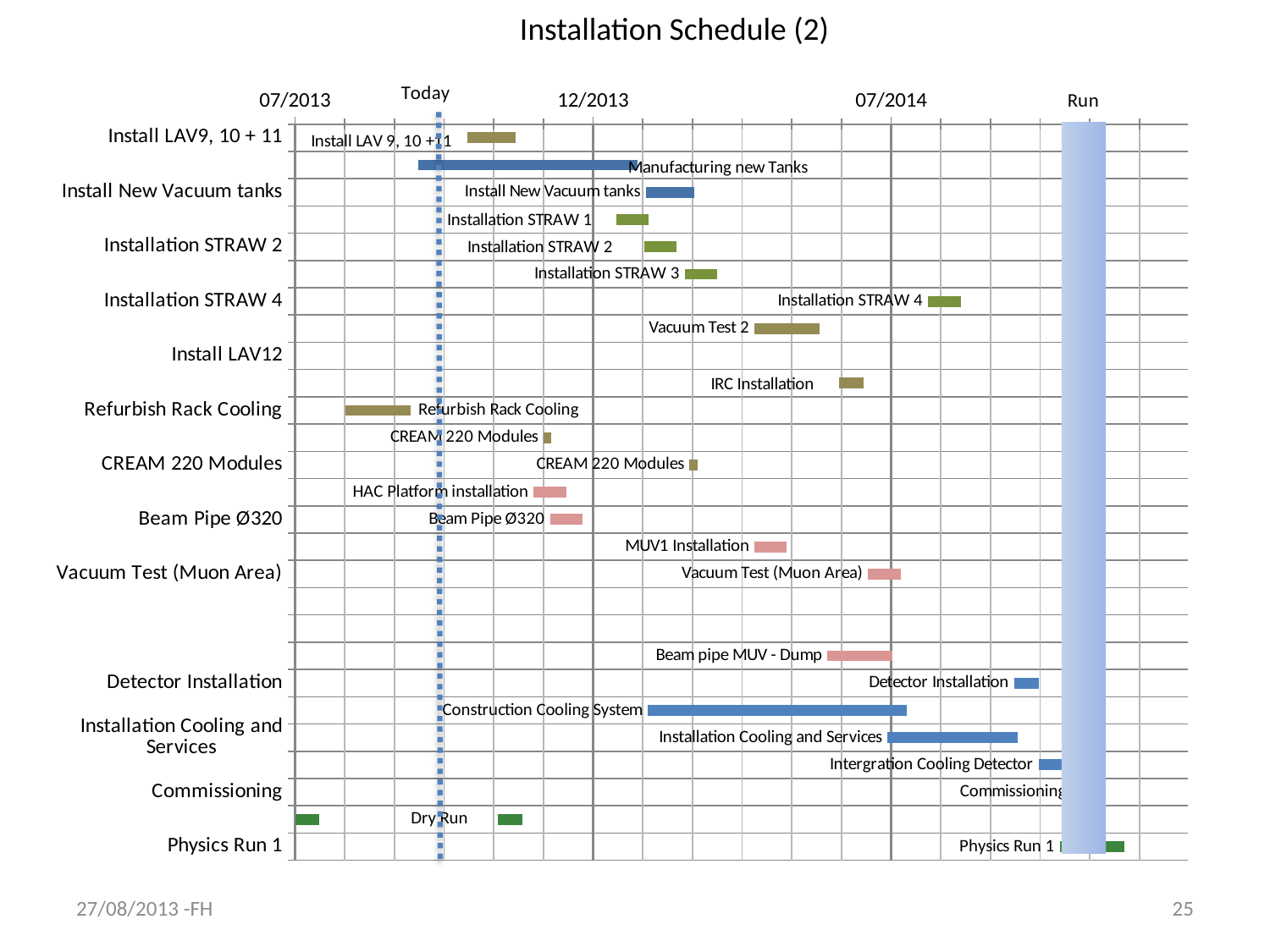
What is the title of the chart? Installation Schedule (2) How many date labels are shown along the time axis at the top of the chart? 3 What does the dotted vertical line on the chart mark? Today Does the Detector Installation bar start before or after 07/2014? after Does the HAC Platform installation bar start before or after 12/2013? before Does the Refurbish Rack Cooling bar start before or after the Today line? before What kind of chart is shown on the slide? bar chart (Gantt schedule) Which is scheduled earlier, Vacuum Test 2 or Vacuum Test (Muon Area)? Vacuum Test 2 Which starts later, Installation STRAW 1 or Installation STRAW 4? Installation STRAW 4 Of Installation STRAW 1, STRAW 2 and STRAW 3, which is scheduled last? Installation STRAW 3 Which task has the longest bar on the chart? Construction Cooling System